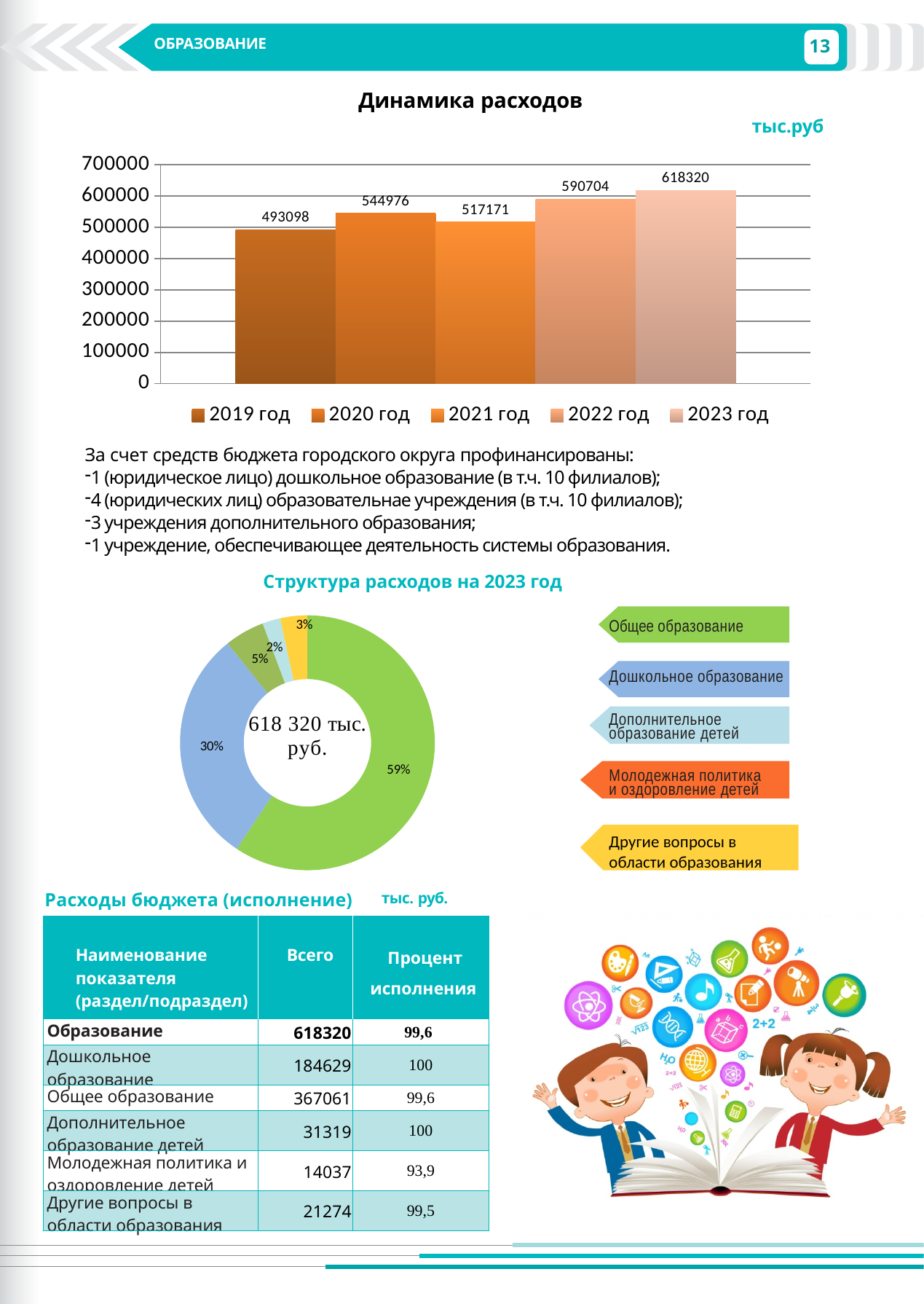
On the 'Структура расходов на 2023 год' chart, what total value is shown in the centre of the doughnut? 618 320 тыс. руб. What type of chart is 'Динамика расходов'? bar chart On the 'Динамика расходов' chart, what is the value for 2021 год? 517171 On the 'Динамика расходов' chart, what is the value for 2023 год? 618320 On the 'Динамика расходов' chart, which year has the highest value? 2023 год On the 'Динамика расходов' chart, what is the value for 2019 год? 493098 On the 'Динамика расходов' chart, what is the difference between the values for 2023 год and 2022 год? 27616 On the 'Структура расходов на 2023 год' chart, what is the share of the largest slice? 59% On the 'Динамика расходов' chart, which year has the lowest value? 2019 год What type of chart is 'Структура расходов на 2023 год'? doughnut chart On the 'Динамика расходов' chart, how many years are shown? 5 On the 'Динамика расходов' chart, which is larger: the value for 2020 год or 2021 год? 2020 год